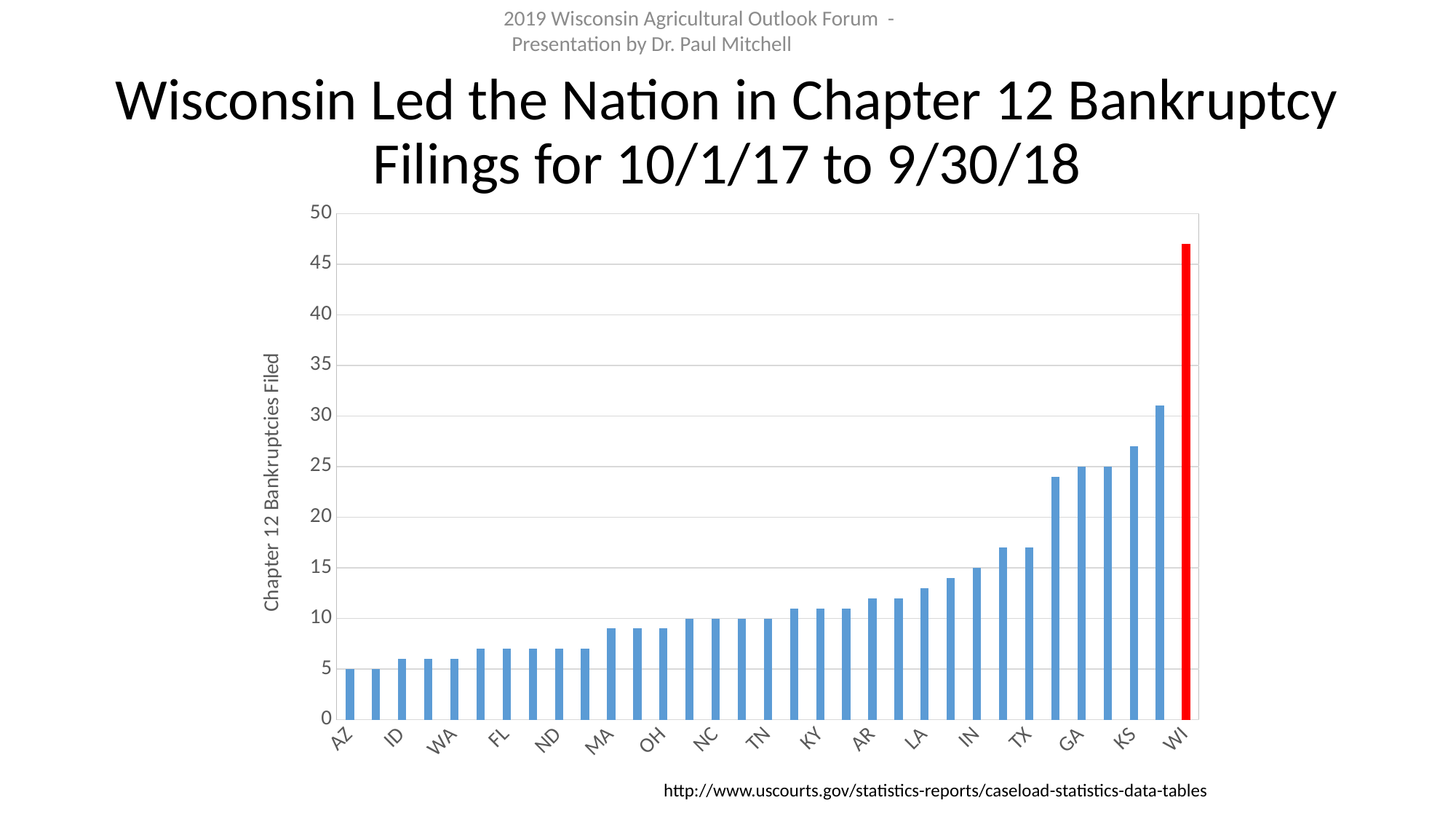
Which has more Chapter 12 bankruptcies filed, KS or GA? KS Is the value for LA greater or less than 15? less Do the values generally rise or fall moving from left to right along the x axis? rise What kind of chart is shown on the slide? bar chart Is the value for WI greater or less than 45? greater Which state's bar is coloured red? WI Is the value for TX greater or less than 15? greater Which state has the highest number of Chapter 12 bankruptcies filed? WI What is the label on the vertical axis? Chapter 12 Bankruptcies Filed